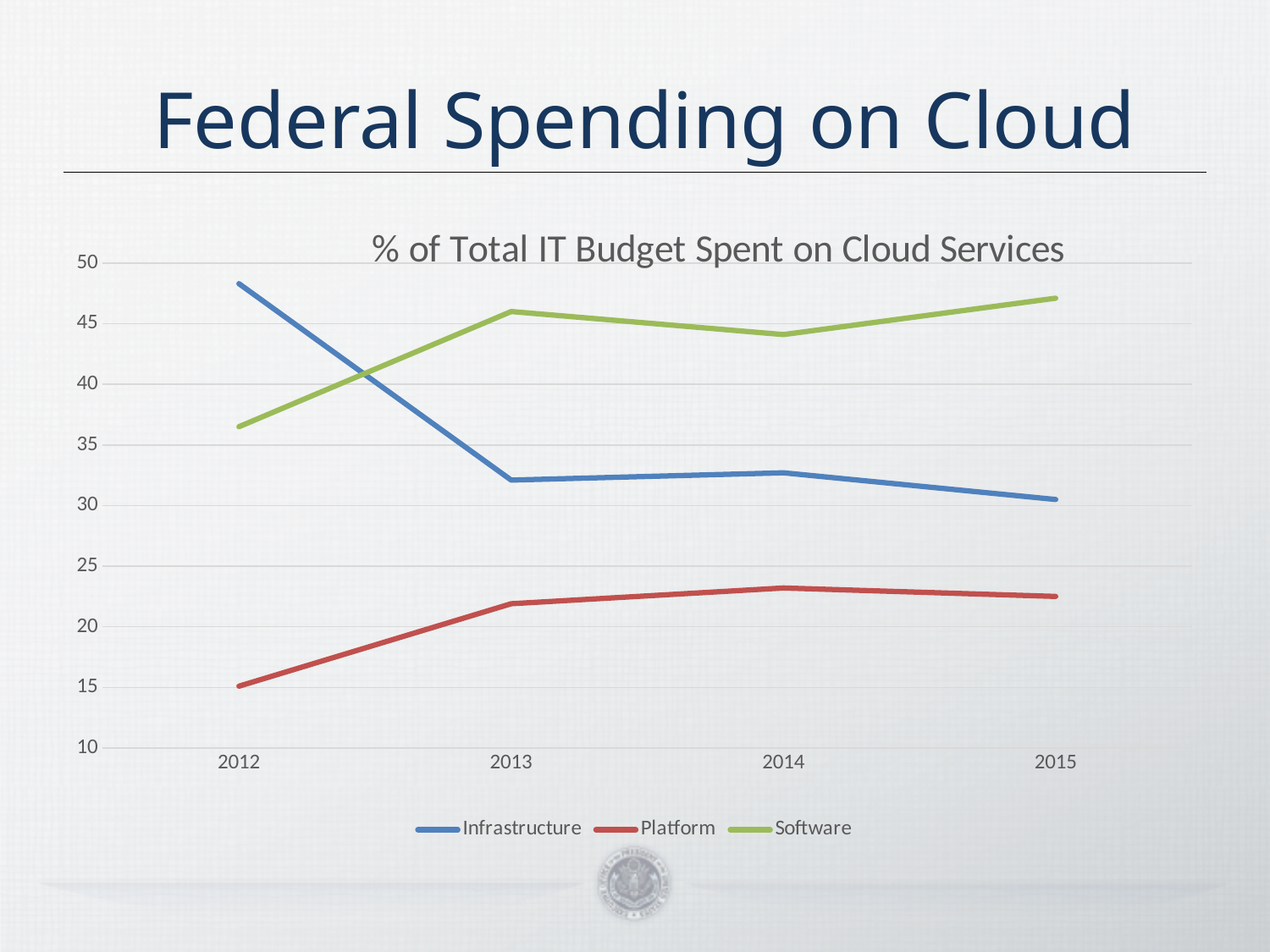
How many series does the legend list? 3 Which series has the lowest value in 2012? Platform What kind of chart is shown on the slide? Line chart Is the value for Platform in 2012 greater or less than 20? less What is the title of the chart? % of Total IT Budget Spent on Cloud Services In which year is the Infrastructure value highest? 2012 How many years are shown on the x axis? 4 In 2012, which is larger: Infrastructure or Software? Infrastructure Which series has the highest value in 2015? Software In 2013, which is larger: Software or Infrastructure? Software Does the Infrastructure line rise or fall from 2012 to 2015? Fall Is the value for Infrastructure in 2012 greater or less than 45? greater